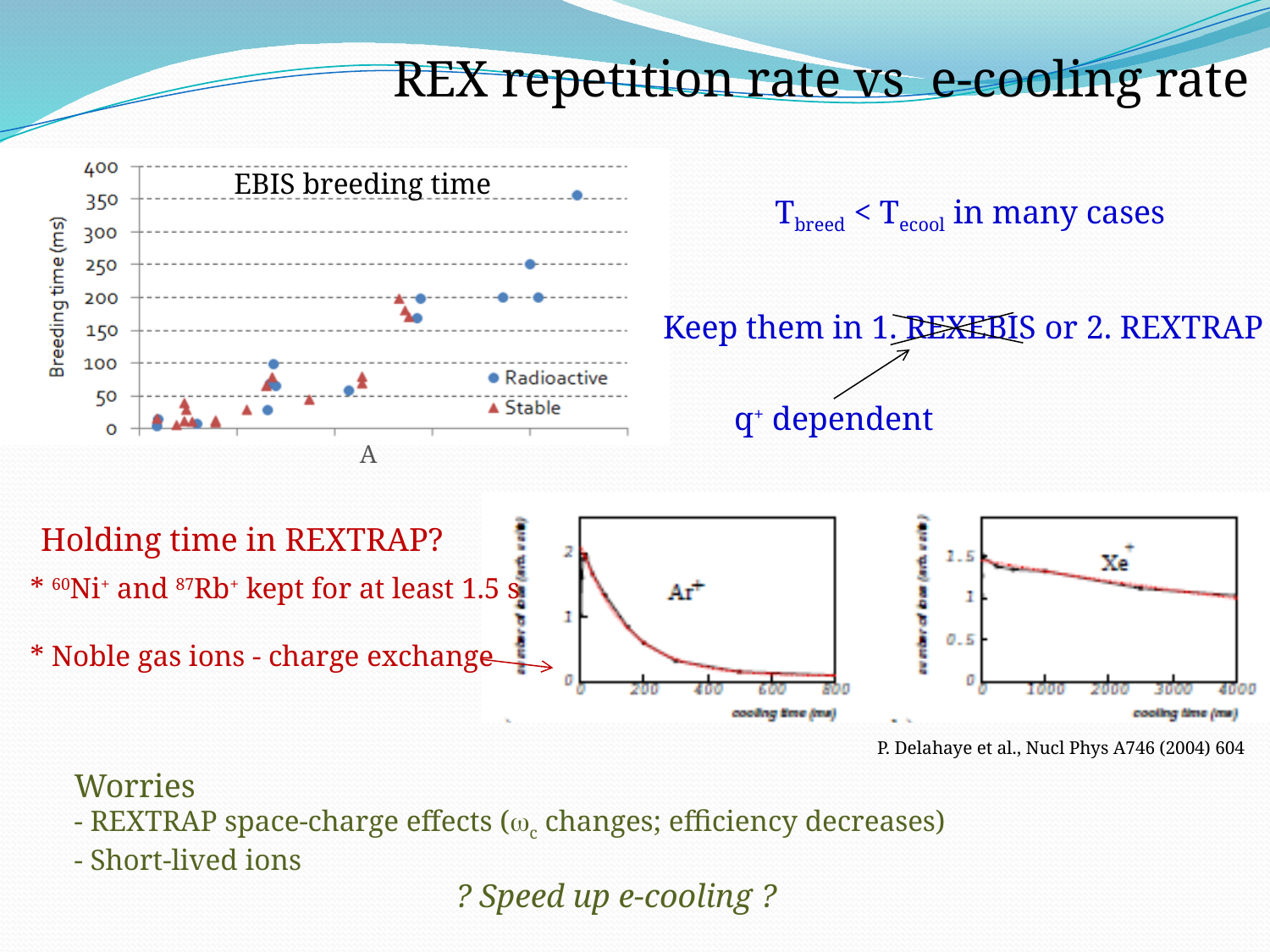
In the 'EBIS breeding time' chart, is the lowest Radioactive point greater or less than 50? less What kind of chart is the 'EBIS breeding time' chart? scatter chart What is the y-axis label of the 'EBIS breeding time' chart? Breeding time (ms) What are the two series named in the legend of the 'EBIS breeding time' chart? Radioactive and Stable In the Xe+ chart at the bottom right of the slide, does the number of ions rise or fall as cooling time increases? fall In the Ar+ chart at the bottom of the slide, does the number of ions rise or fall as cooling time increases? fall In the 'EBIS breeding time' chart, is the highest Radioactive point greater or less than 300? greater How many series does the legend of the 'EBIS breeding time' chart list? 2 In the Ar+ chart at the bottom of the slide, is the value at cooling time 0 greater or less than 1? greater In the 'EBIS breeding time' chart, which series contains the point with the highest breeding time, Radioactive or Stable? Radioactive